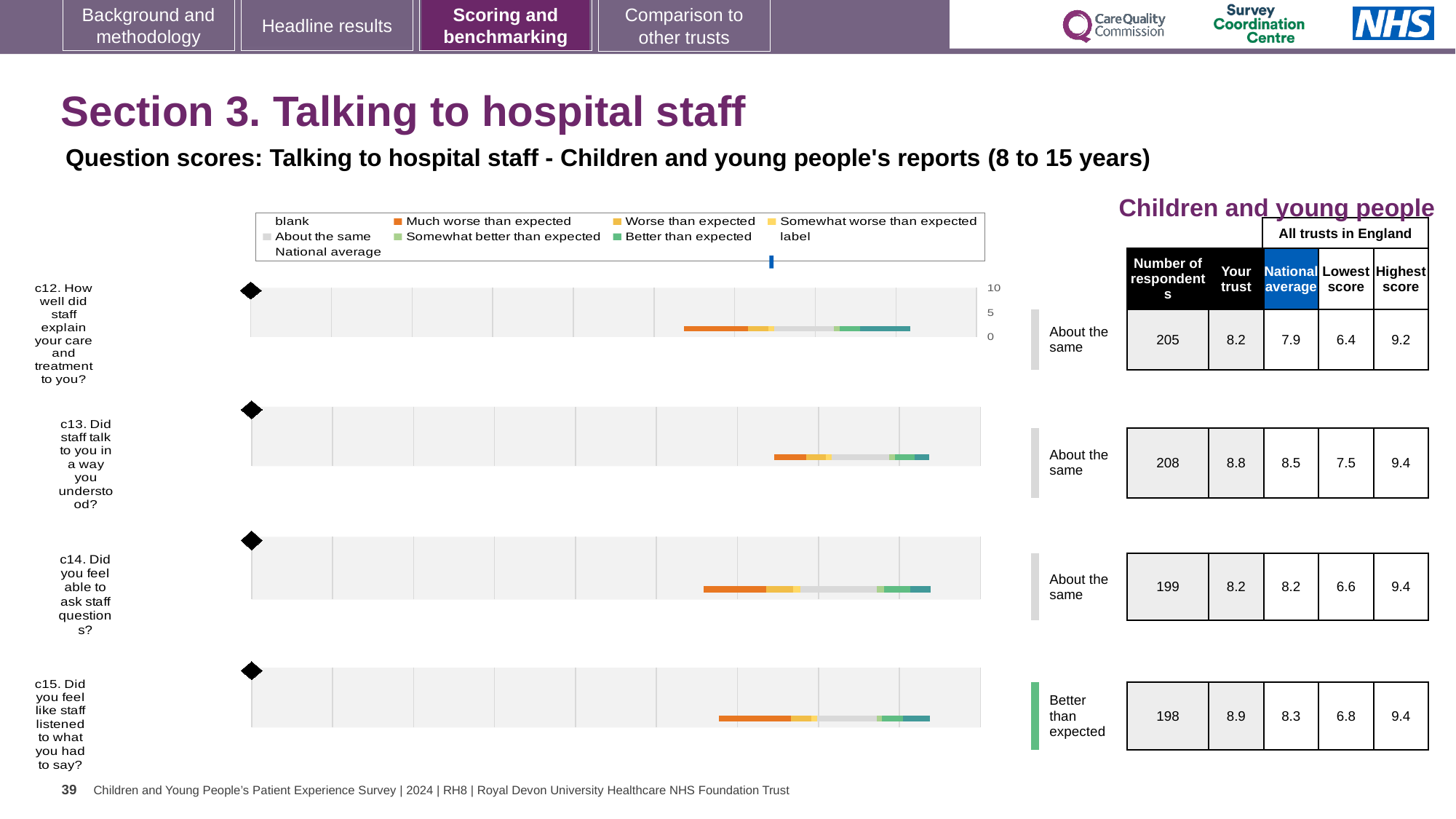
For c15, what is the difference between the 'Your trust' score and the national average? 0.6 For c15 (Did you feel like staff listened to what you had to say?), what is the 'Your trust' score? 8.9 For c12 (How well did staff explain your care and treatment to you?), what is the highest score among all trusts in England? 9.2 Which question has the highest 'Your trust' score? c15 Which question has the lowest national average score? c12 What kind of chart is used for each question on this slide? bar chart For c13, which is larger: the 'Your trust' score or the national average? Your trust Which question is rated 'Better than expected' rather than 'About the same'? c15 How many survey questions (c12 to c15) have a chart on this slide? 4 How many respondents answered c14 (Did you feel able to ask staff questions?)? 199 For c13 (Did staff talk to you in a way you understood?), what is the national average score? 8.5 In the legend, what colour represents 'Much worse than expected'? orange